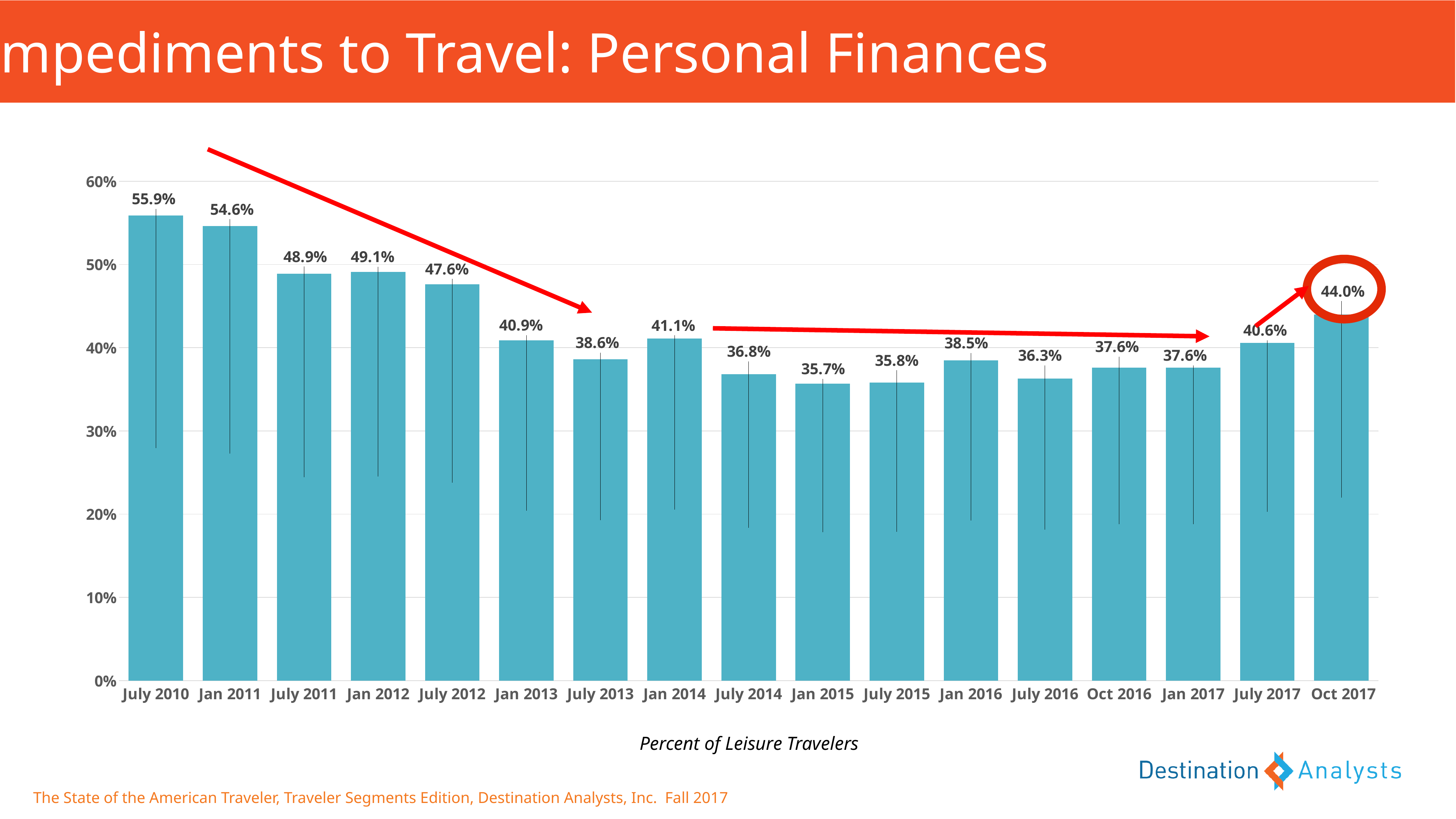
What is the value for July 2010? 55.9% How many periods are shown on the x axis? 17 What kind of chart is shown on the slide? bar chart Is the value for July 2014 greater or less than 40%? less What is the difference between the values for Oct 2017 and July 2017? 3.4% What is the value for Jan 2014? 41.1% What is the x-axis caption below the chart? Percent of Leisure Travelers What is the difference between the values for July 2010 and Jan 2011? 1.3% What is the value for Oct 2017? 44.0% Which is larger, the value for Jan 2013 or the value for July 2013? Jan 2013 What is the value for July 2017? 40.6% Which period has the highest value? July 2010